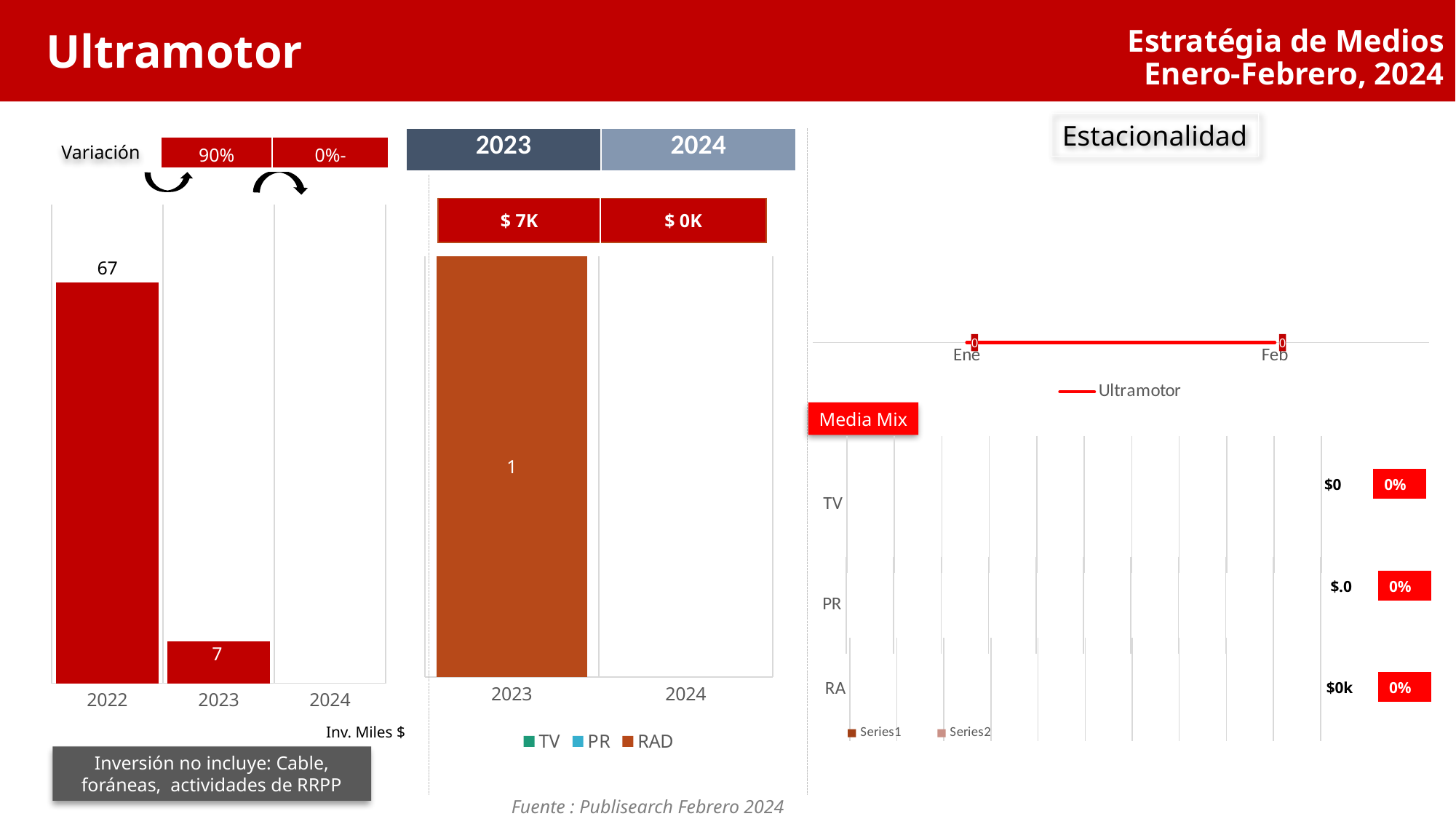
In the middle stacked bar chart, what total is shown above the 2023 bar? $ 7K In the left bar chart, what is the value for 2022? 67 What kind of chart is the left chart showing 2022, 2023 and 2024? bar chart In the left bar chart, which year has the highest value? 2022 In the left bar chart, what is the value for 2023? 7 In the middle stacked bar chart, what is the RAD value for 2023? 1 In the middle stacked bar chart, how many series does the legend list? 3 In the Estacionalidad line chart, what is the value for Feb? 0 In the Media Mix chart, what percentage is shown for TV? 0% In the left bar chart, do the values rise or fall from 2022 to 2023? fall In the left bar chart, which is larger, the value for 2022 or the value for 2023? 2022 In the left bar chart, what is the difference between the 2022 and 2023 values? 60